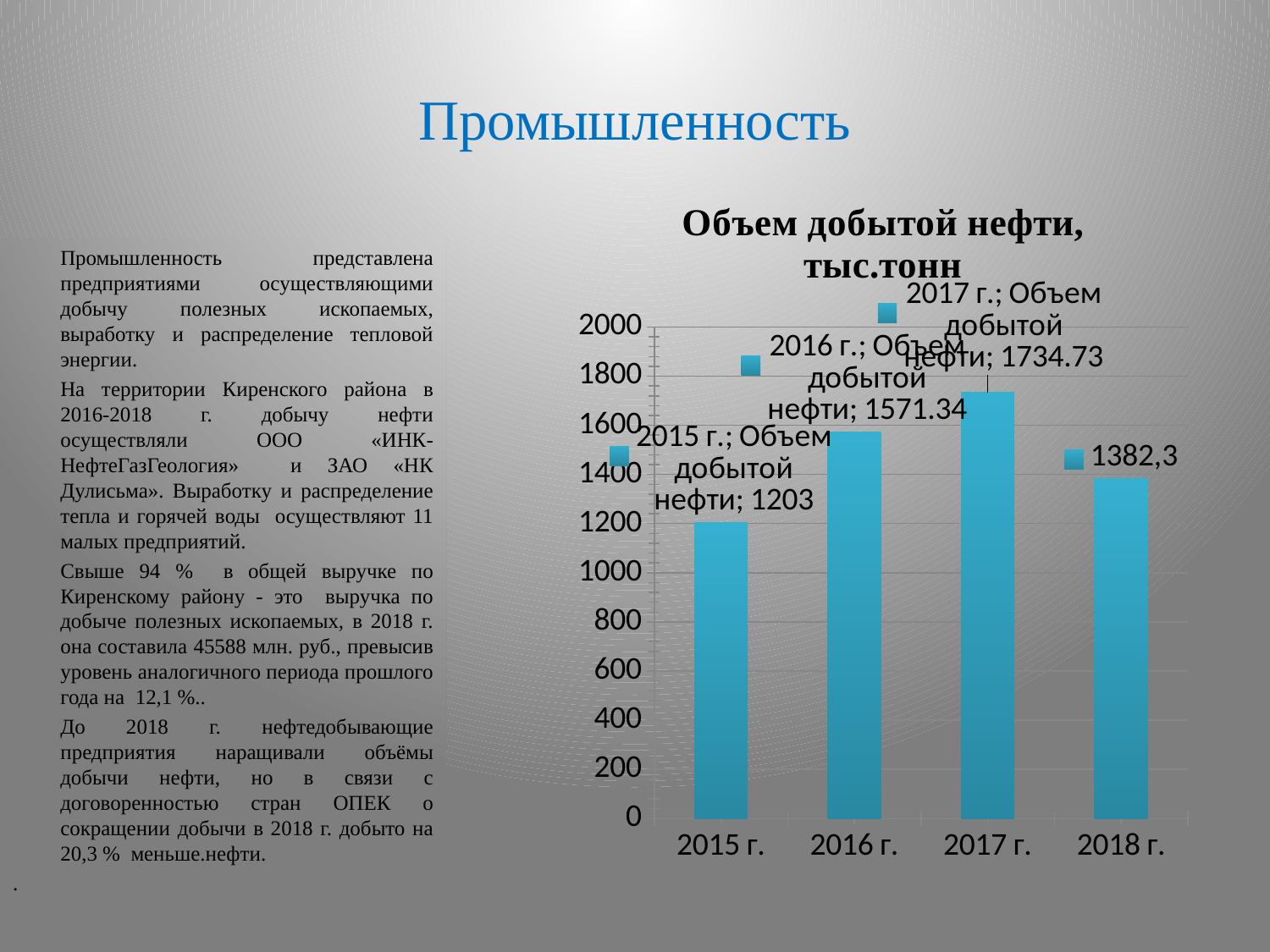
What kind of chart is "Объем добытой нефти, тыс.тонн"? bar chart What is the value for 2015 г. in the chart "Объем добытой нефти, тыс.тонн"? 1203 How many years are shown on the x axis of the chart "Объем добытой нефти, тыс.тонн"? 4 What is the value for 2018 г. in the chart "Объем добытой нефти, тыс.тонн"? 1382,3 Is the value for 2017 г. in the chart "Объем добытой нефти, тыс.тонн" greater or less than 1600? greater What is the value for 2017 г. in the chart "Объем добытой нефти, тыс.тонн"? 1734.73 What is the title of the chart on the slide? Объем добытой нефти, тыс.тонн Which year has the highest value in the chart "Объем добытой нефти, тыс.тонн"? 2017 г. What is the value for 2016 г. in the chart "Объем добытой нефти, тыс.тонн"? 1571.34 Which year has the lowest value in the chart "Объем добытой нефти, тыс.тонн"? 2015 г. In the chart "Объем добытой нефти, тыс.тонн", does the value rise or fall from 2017 г. to 2018 г.? fall Which is larger in the chart "Объем добытой нефти, тыс.тонн": the value for 2016 г. or for 2018 г.? 2016 г.